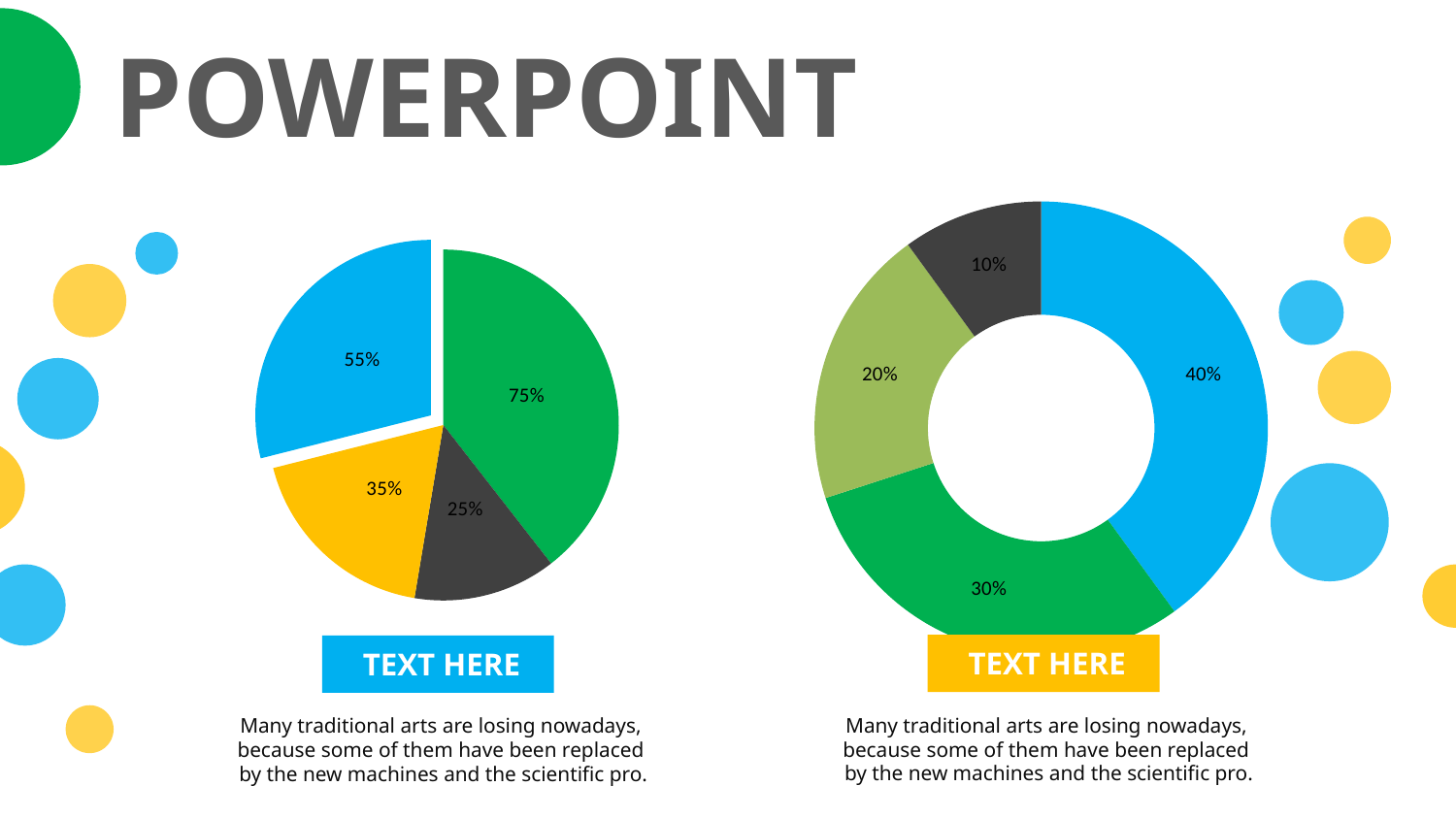
In the pie chart on the left, which slice has the highest labelled value? the green slice (75%) In the pie chart on the left, what is the difference between the blue slice's value and the yellow slice's value? 20% In the pie chart on the left, how many slices are there? 4 In the pie chart on the left, what value is shown on the yellow slice? 35% In the pie chart on the left, what value is shown on the green slice? 75% In the doughnut chart on the right, which slice has the lowest value? the dark grey slice (10%) What type of chart is the chart on the left side of the slide? pie chart In the pie chart on the left, what value is shown on the dark grey slice? 25% In the doughnut chart on the right, what value is shown on the light green slice? 20% In the doughnut chart on the right, how many slices are there? 4 What type of chart is the chart on the right side of the slide? doughnut chart In the doughnut chart on the right, which is larger: the blue slice or the green slice? the blue slice